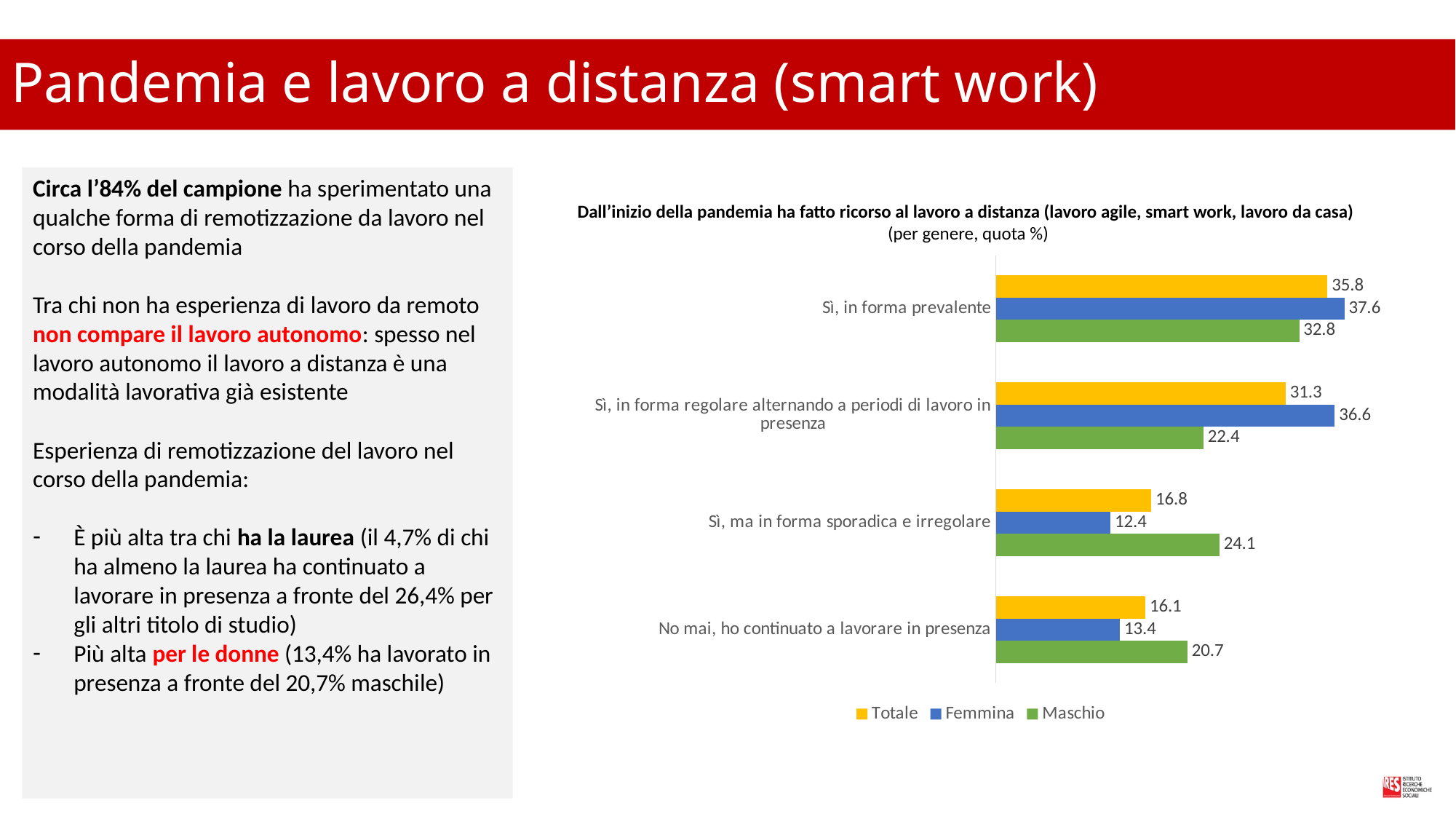
Which colour represents the Maschio series in the chart? Green What is the Maschio value for 'No mai, ho continuato a lavorare in presenza'? 20.7 What is the difference between the Femmina and Maschio values for 'Sì, in forma regolare alternando a periodi di lavoro in presenza'? 14.2 What is the Femmina value for 'Sì, ma in forma sporadica e irregolare'? 12.4 Which category has the lowest Maschio value? No mai, ho continuato a lavorare in presenza What kind of chart is shown on the slide? Bar chart How many series does the legend list? 3 How many categories are shown on the chart? 4 What is the Totale value for 'Sì, in forma prevalente'? 35.8 Which category has the highest Femmina value? Sì, in forma prevalente What is the Femmina value for 'Sì, in forma regolare alternando a periodi di lavoro in presenza'? 36.6 For 'Sì, ma in forma sporadica e irregolare', which is larger: the Femmina value or the Maschio value? Maschio